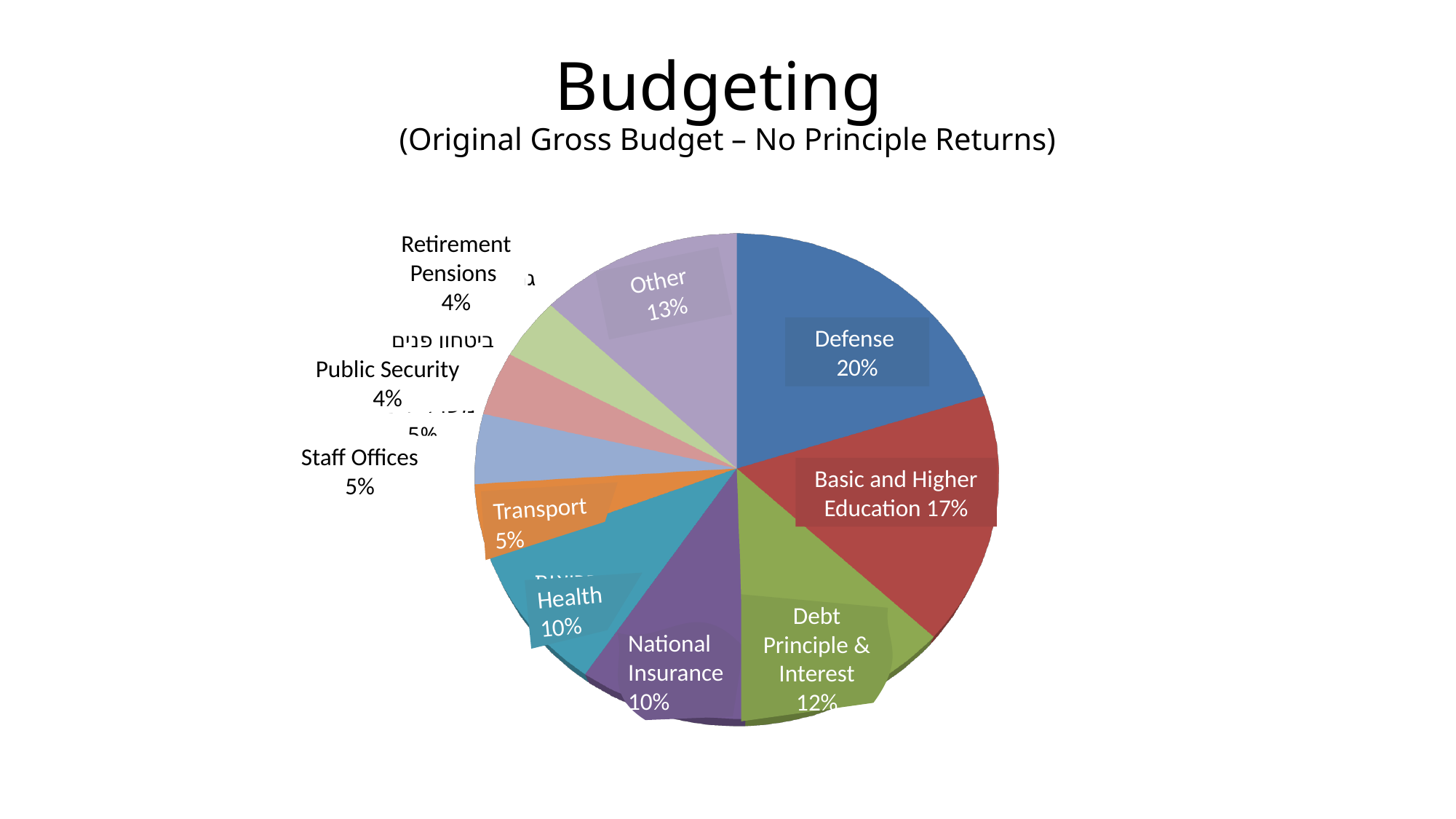
Which category has the largest share of the pie? Defense What is the value for Retirement Pensions? 4% Which is larger, the share for Other or the share for Debt Principle & Interest? Other What is the value for National Insurance? 10% What share of the budget does Defense take? 20% What kind of chart is shown on the slide? pie chart What is the difference between the Defense share and the Basic and Higher Education share? 3% What is the subtitle shown under the chart title 'Budgeting'? (Original Gross Budget – No Principle Returns) What is the value for Basic and Higher Education? 17% What is the value for Debt Principle & Interest? 12% What is the value for Transport? 5% What is the value for Staff Offices? 5%